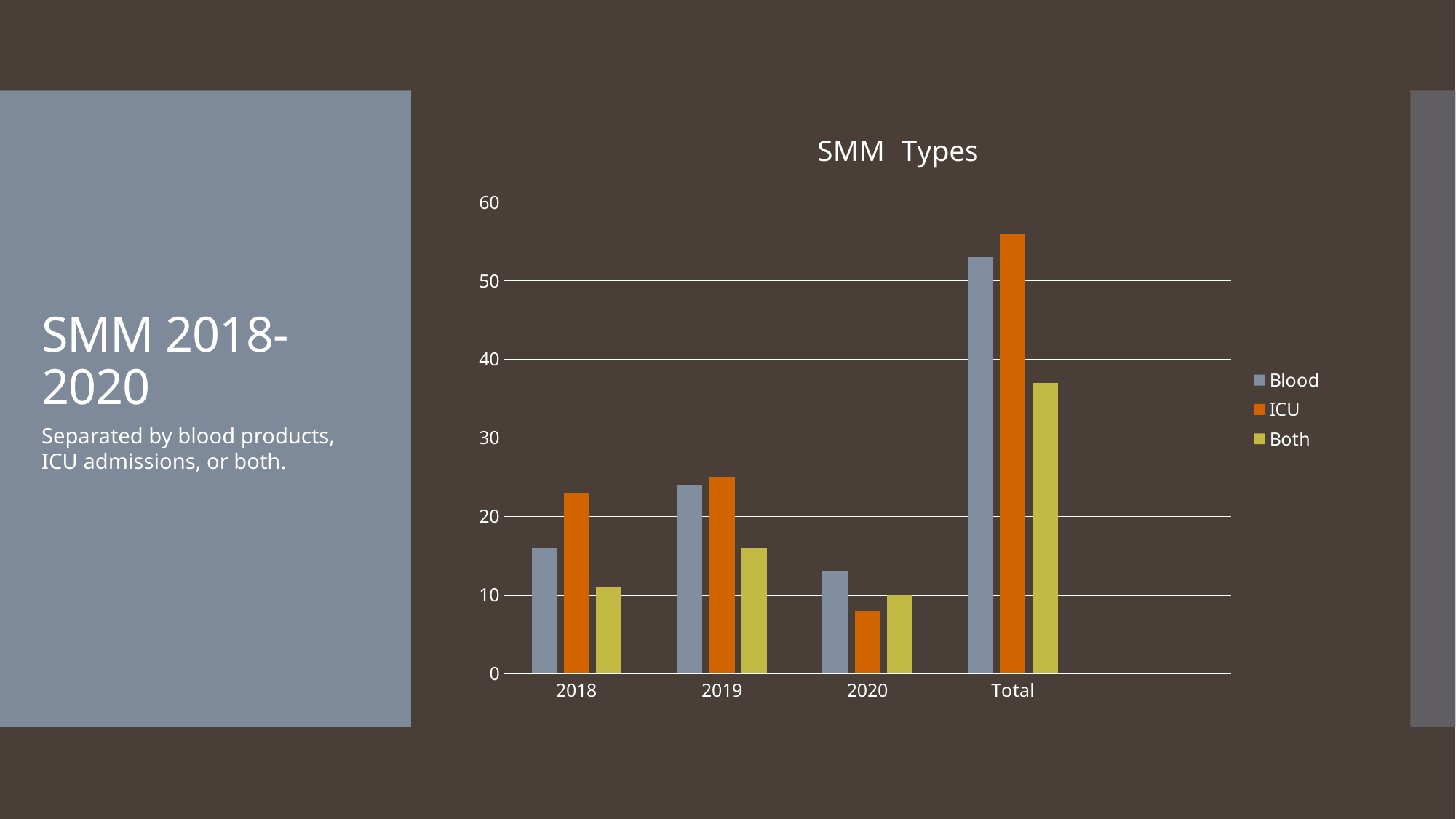
What is the title of the chart? SMM Types What kind of chart is shown on the slide? bar chart Is the Both value for Total greater or less than 30? greater Is the ICU value for 2020 greater or less than 10? less How many series does the legend of the SMM Types chart list? 3 Is the Blood value for 2018 greater or less than 20? less In 2018, which is larger, the Blood value or the ICU value? ICU Among the years 2018, 2019 and 2020, which year has the lowest ICU value? 2020 Does the Blood value rise or fall from 2019 to 2020? fall Which colour represents the ICU series in the legend? orange How many categories are shown on the x axis of the SMM Types chart? 4